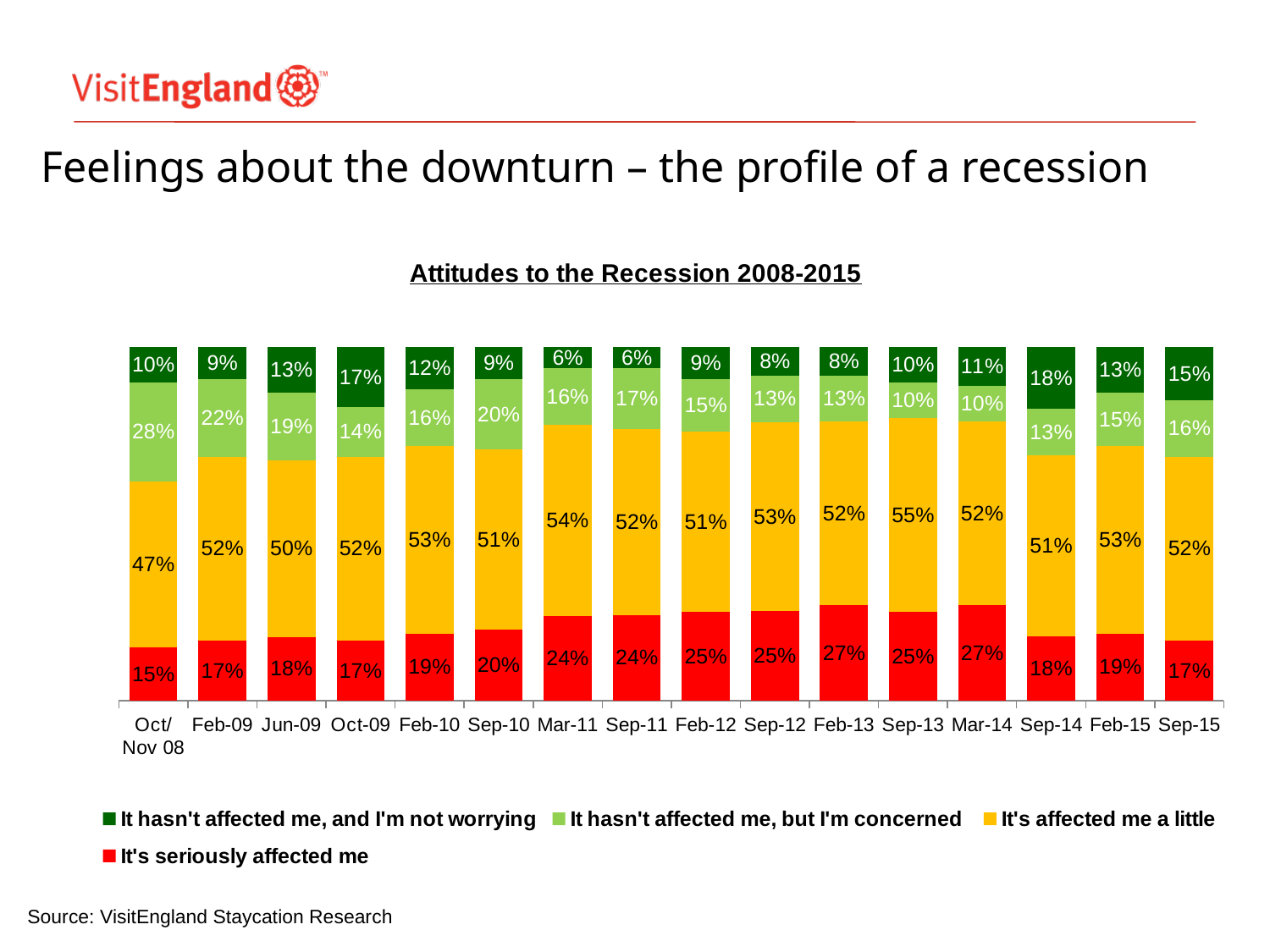
In which period was the share for 'It's seriously affected me' lowest? Oct/Nov 08 What percentage said 'It's affected me a little' in Oct/Nov 08? 47% How many time periods are shown along the x axis? 16 What percentage said 'It hasn't affected me, but I'm concerned' in Sep-15? 16% What percentage said 'It's seriously affected me' in Feb-13? 27% What type of chart is shown on the slide? Stacked bar chart In which period was the share for 'It hasn't affected me, and I'm not worrying' highest? Sep-14 What is the difference between the 'It's seriously affected me' values for Mar-14 and Sep-14? 9 percentage points How many series does the legend list? 4 In which period was the share for 'It's affected me a little' highest? Sep-13 Which is larger: the 'It hasn't affected me, but I'm concerned' value in Feb-09 or in Sep-12? Feb-09 What is the title of the chart? Attitudes to the Recession 2008-2015